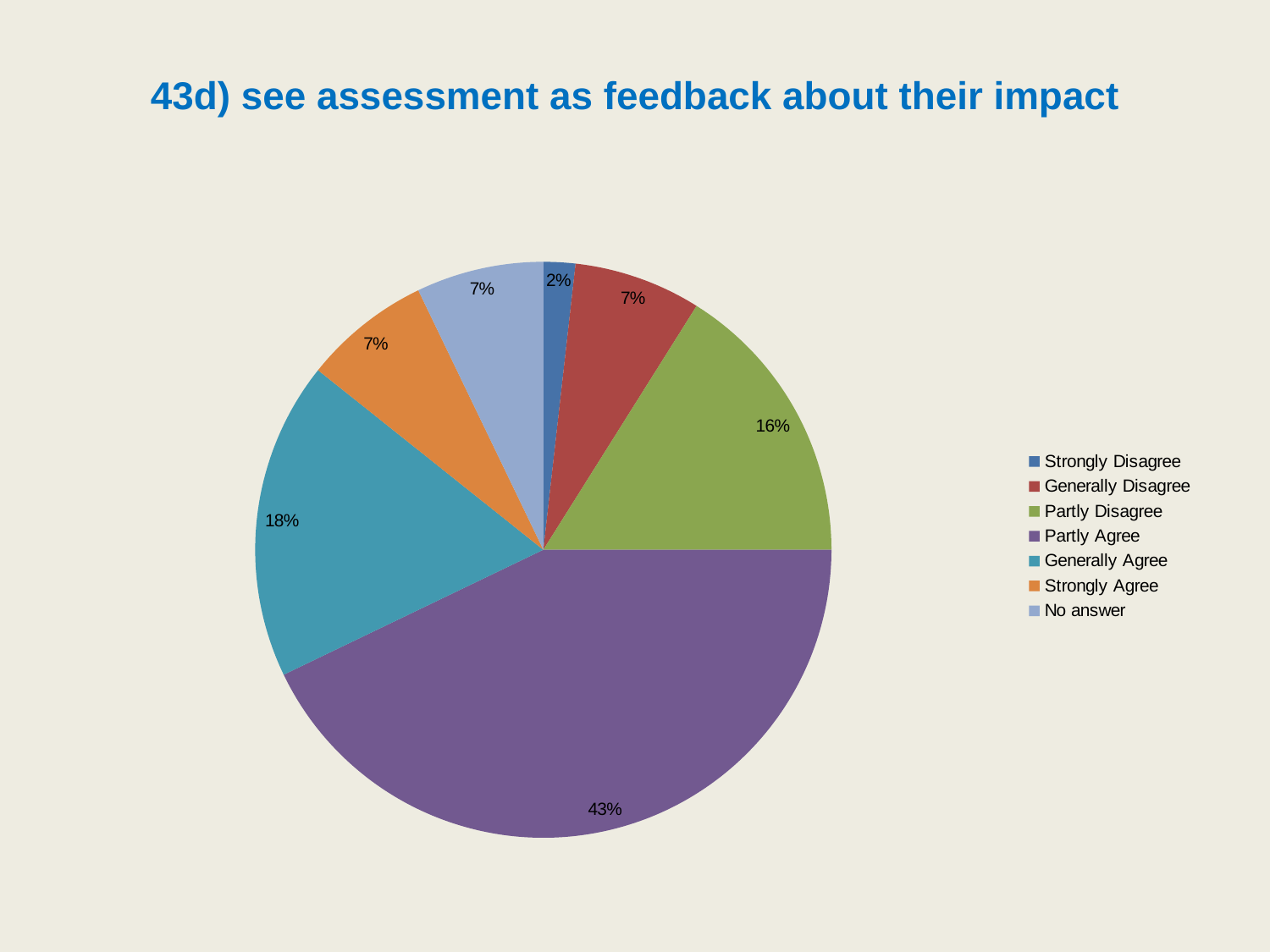
What share of the pie is Generally Agree? 18% Which category has the largest slice of the pie? Partly Agree What is the difference between the Partly Agree share and the Generally Agree share? 25% What kind of chart is shown on the slide? pie chart What is the title of the chart? 43d) see assessment as feedback about their impact What share of the pie is Partly Agree? 43% How many categories does the legend list? 7 Which is larger, the Partly Disagree slice or the Generally Agree slice? Generally Agree What share of the pie is Partly Disagree? 16% Which category has the smallest slice of the pie? Strongly Disagree